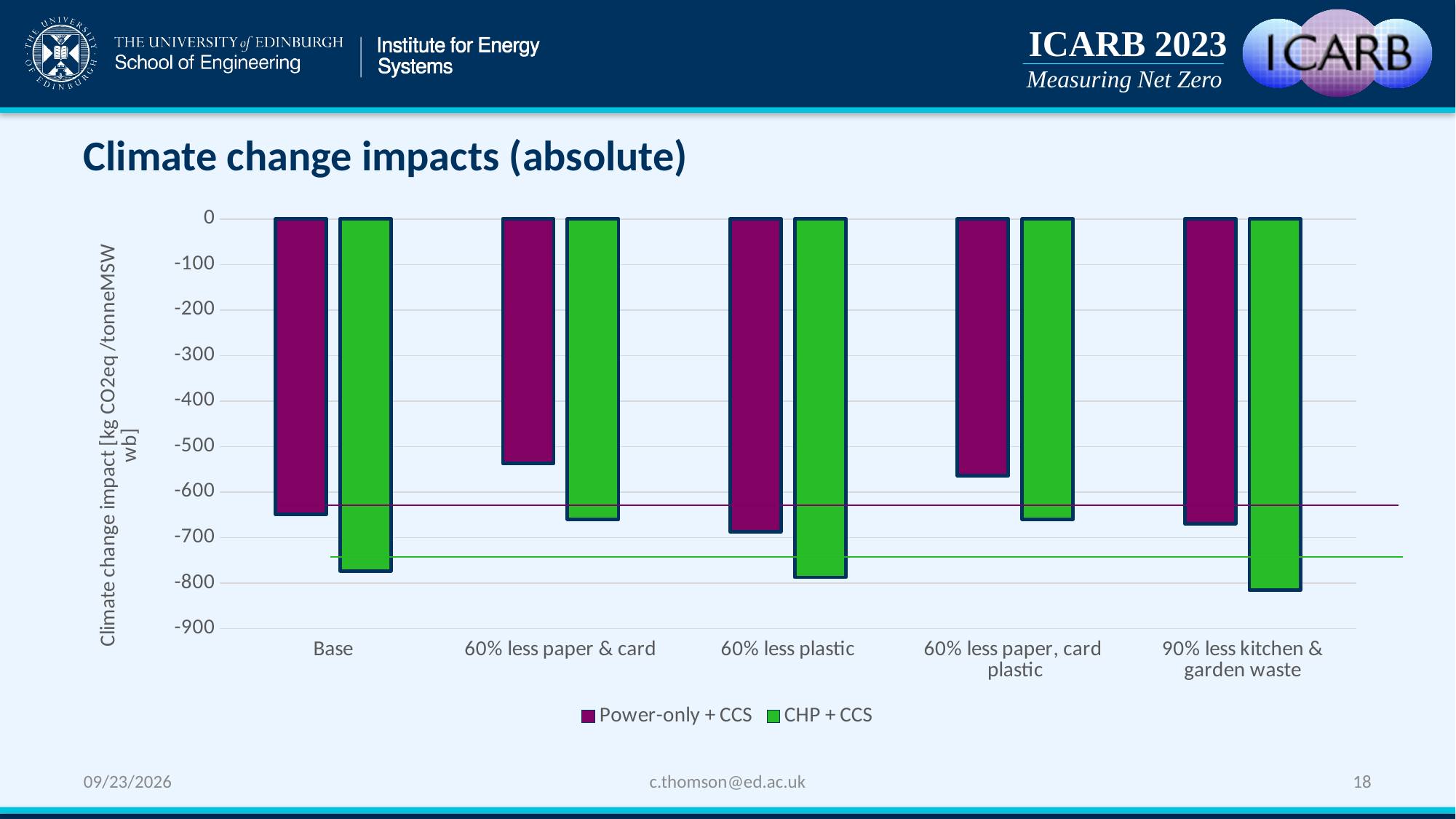
What kind of chart is shown on the slide? bar chart What is the title of the chart on the slide? Climate change impacts (absolute) Is the value for 60% less paper & card in the Power-only + CCS series greater or less than -600? greater How many categories are shown on the x axis of the chart? 5 What are the two series named in the chart's legend? Power-only + CCS and CHP + CCS Is the value for Base in the Power-only + CCS series greater or less than -600? less Is the value for 90% less kitchen & garden waste in the CHP + CCS series greater or less than -800? less For the Base category, which series has the lower (more negative) value? CHP + CCS Which category has the highest (least negative) value for the Power-only + CCS series? 60% less paper & card How many series does the chart's legend list? 2 For the 60% less plastic category, which series has the higher (less negative) value? Power-only + CCS Which category has the lowest (most negative) value for the CHP + CCS series? 90% less kitchen & garden waste